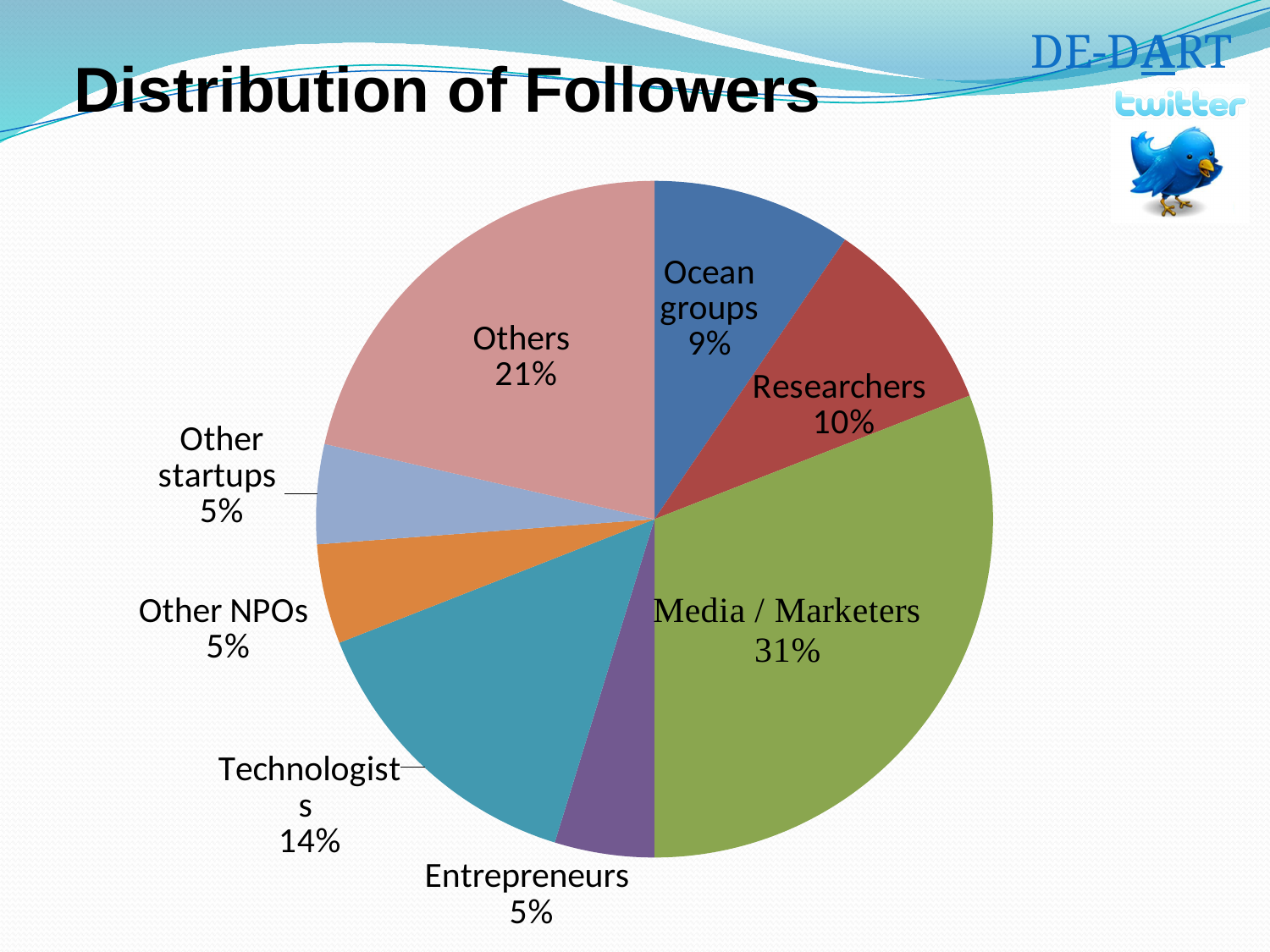
What is the difference in percentage points between Media / Marketers and Others? 10% Which category has the largest share of followers? Media / Marketers What is the title of the chart on the slide? Distribution of Followers Which is larger, the share for Technologists or the share for Researchers? Technologists What share of followers are Researchers? 10% What kind of chart is shown on the slide? Pie chart What share of followers are Media / Marketers? 31% What percentage of followers are Ocean groups? 9% How many slices does the pie chart have? 8 What share of followers falls under Others? 21% What is the difference between the Technologists share and the Entrepreneurs share? 9% What percentage of followers are Technologists? 14%